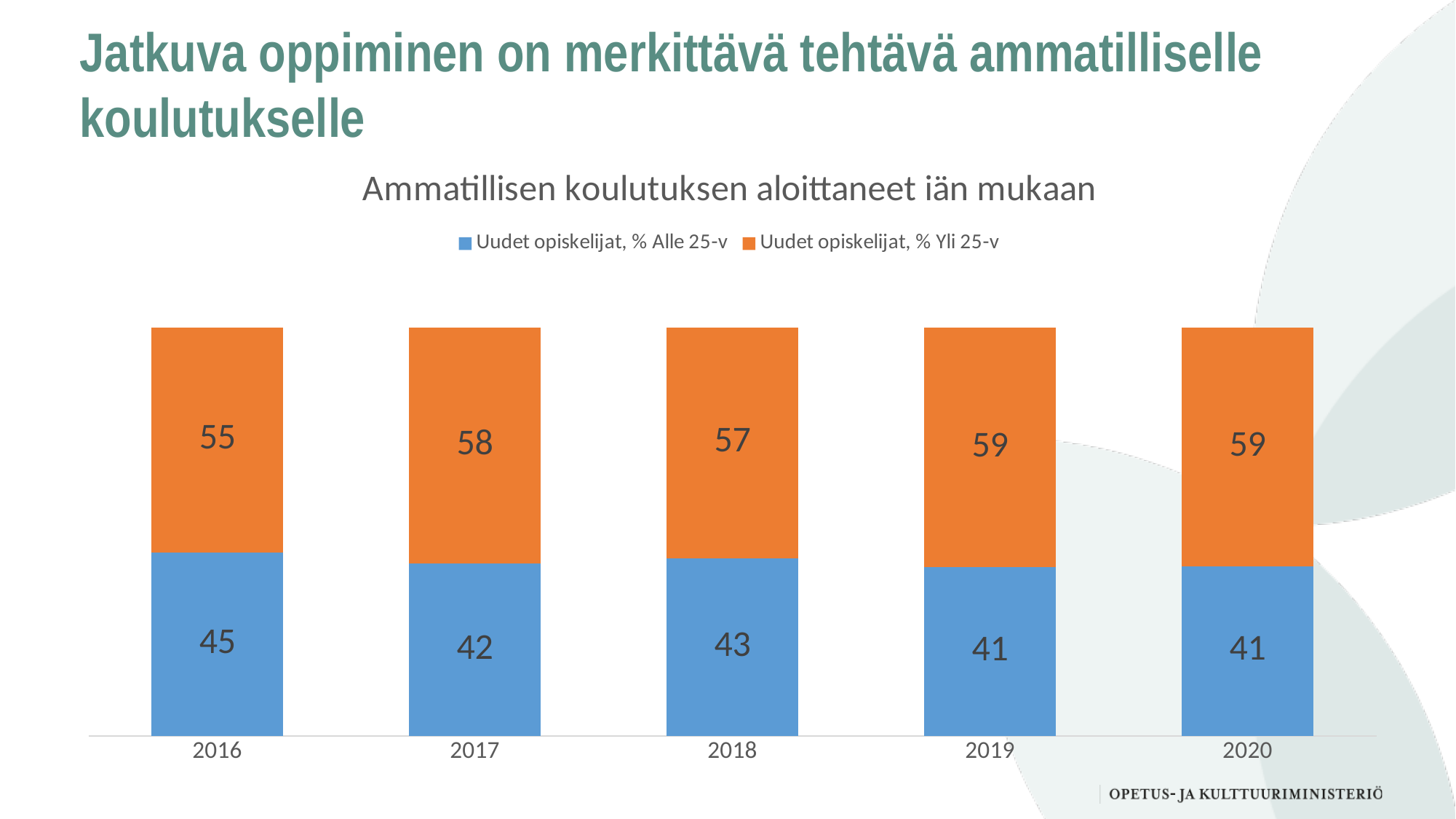
What kind of chart is shown? stacked bar chart What is the value for 'Uudet opiskelijat, % Alle 25-v' in 2020? 41 Which is larger in 2017: the value for 'Uudet opiskelijat, % Alle 25-v' or 'Uudet opiskelijat, % Yli 25-v'? Uudet opiskelijat, % Yli 25-v In which year is the value for 'Uudet opiskelijat, % Yli 25-v' lowest? 2016 What is the value for 'Uudet opiskelijat, % Alle 25-v' in 2016? 45 What is the difference between the 'Uudet opiskelijat, % Yli 25-v' values for 2019 and 2016? 4 What is the title of the chart? Ammatillisen koulutuksen aloittaneet iän mukaan How many years are shown on the x axis? 5 What is the value for 'Uudet opiskelijat, % Yli 25-v' in 2018? 57 In which year is the value for 'Uudet opiskelijat, % Alle 25-v' highest? 2016 What is the total of the stacked bar for 2018? 100 How many series does the legend list? 2